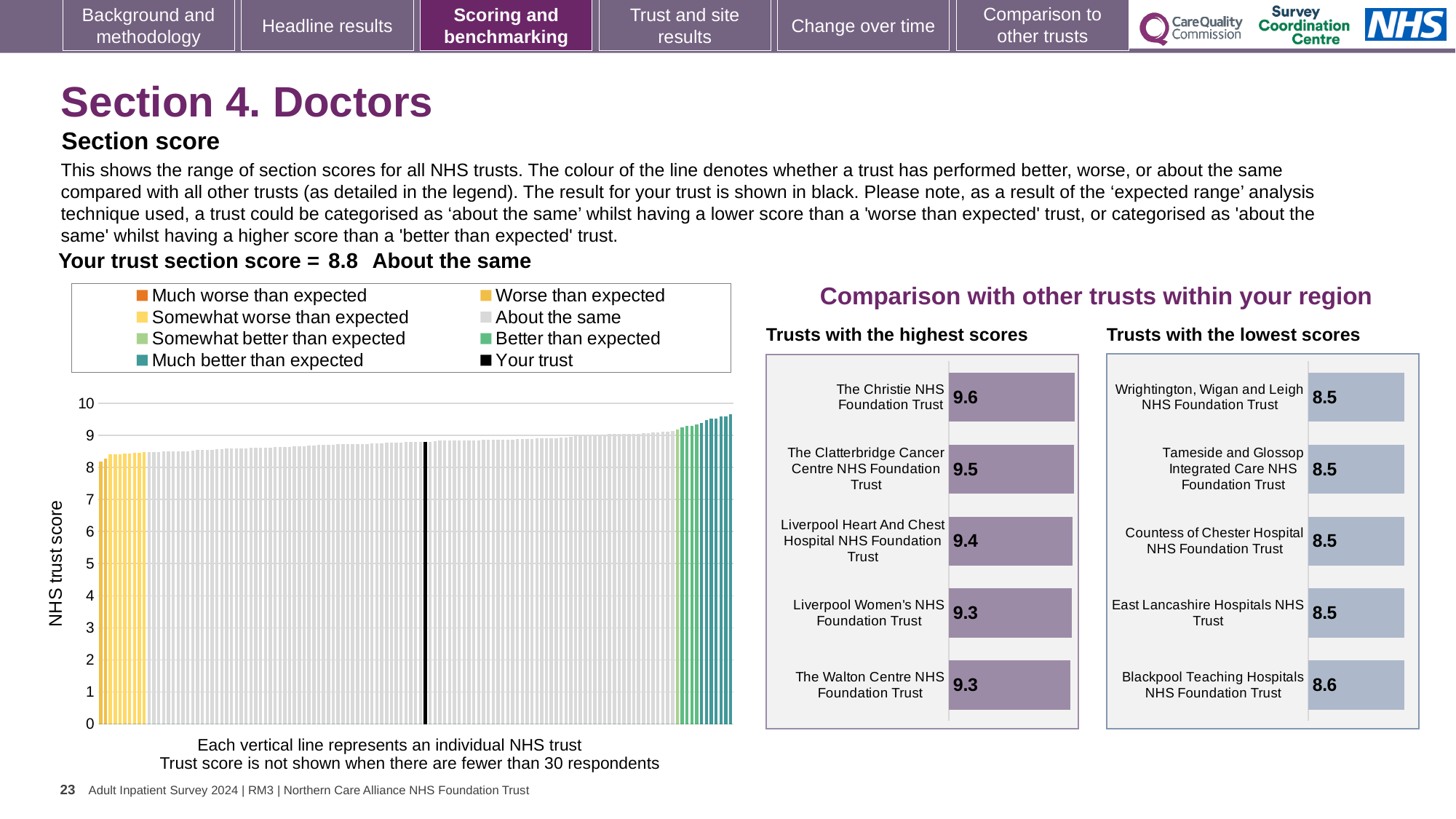
In the main NHS trust score chart on the left, what kind of chart is shown? Bar chart In the 'Trusts with the highest scores' chart, how many trusts are listed? 5 In the 'Trusts with the lowest scores' chart, what is the score for Countess of Chester Hospital NHS Foundation Trust? 8.5 In the 'Trusts with the highest scores' chart, what is the score for Liverpool Heart And Chest Hospital NHS Foundation Trust? 9.4 In the 'Trusts with the highest scores' chart, what is the score for The Christie NHS Foundation Trust? 9.6 In the 'Trusts with the highest scores' chart, which trust has the highest score? The Christie NHS Foundation Trust In the main NHS trust score chart on the left, do the trust scores rise or fall from left to right? Rise In the 'Trusts with the lowest scores' chart, what is the score for Blackpool Teaching Hospitals NHS Foundation Trust? 8.6 In the 'Trusts with the lowest scores' chart, which has the larger score: Blackpool Teaching Hospitals NHS Foundation Trust or East Lancashire Hospitals NHS Trust? Blackpool Teaching Hospitals NHS Foundation Trust In the 'Trusts with the lowest scores' chart, which trust has the highest score? Blackpool Teaching Hospitals NHS Foundation Trust In the main NHS trust score chart on the left, how many entries does the legend list? 8 In the 'Trusts with the highest scores' chart, what is the difference between the scores of The Christie NHS Foundation Trust and The Walton Centre NHS Foundation Trust? 0.3